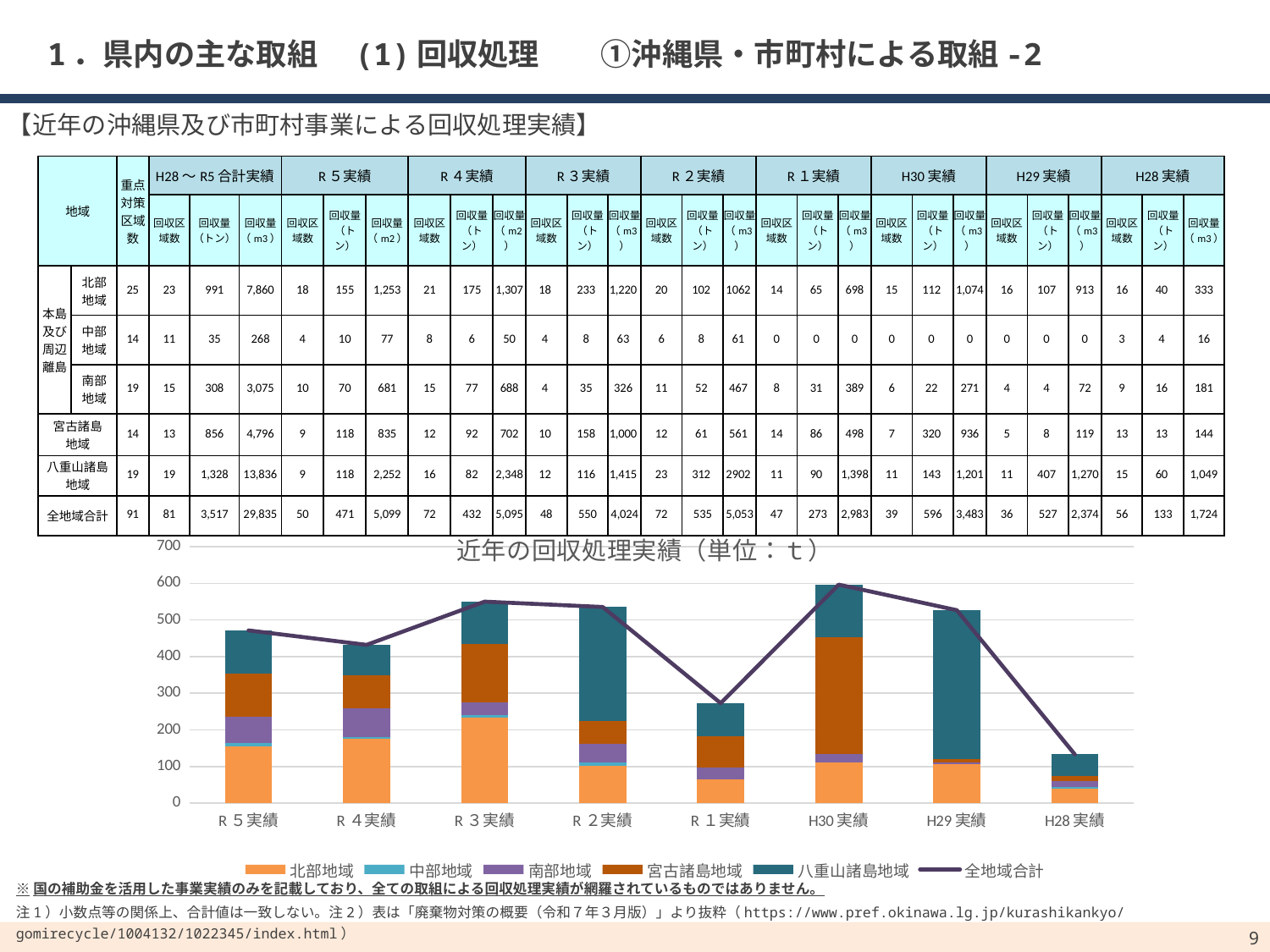
Does the 全地域合計 line rise or fall from H30実績 to H28実績? fall What is the title of the chart on the slide? 近年の回収処理実績（単位：t） In which year is the 全地域合計 line at its lowest point? H28実績 What kind of chart is shown below the table? stacked bar chart with a line Is the 全地域合計 value for H30実績 greater or less than 500? greater Which series is drawn as a line rather than stacked bars in the chart? 全地域合計 Is the 全地域合計 value for H28実績 greater or less than 200? less How many fiscal-year categories are shown on the x axis of the chart? 8 Which has the larger 全地域合計 value, R1実績 or H29実績? H29実績 Is the 全地域合計 value for R2実績 greater or less than 400? greater How many series does the chart legend list? 6 In which year is the 全地域合計 line at its highest point? H30実績